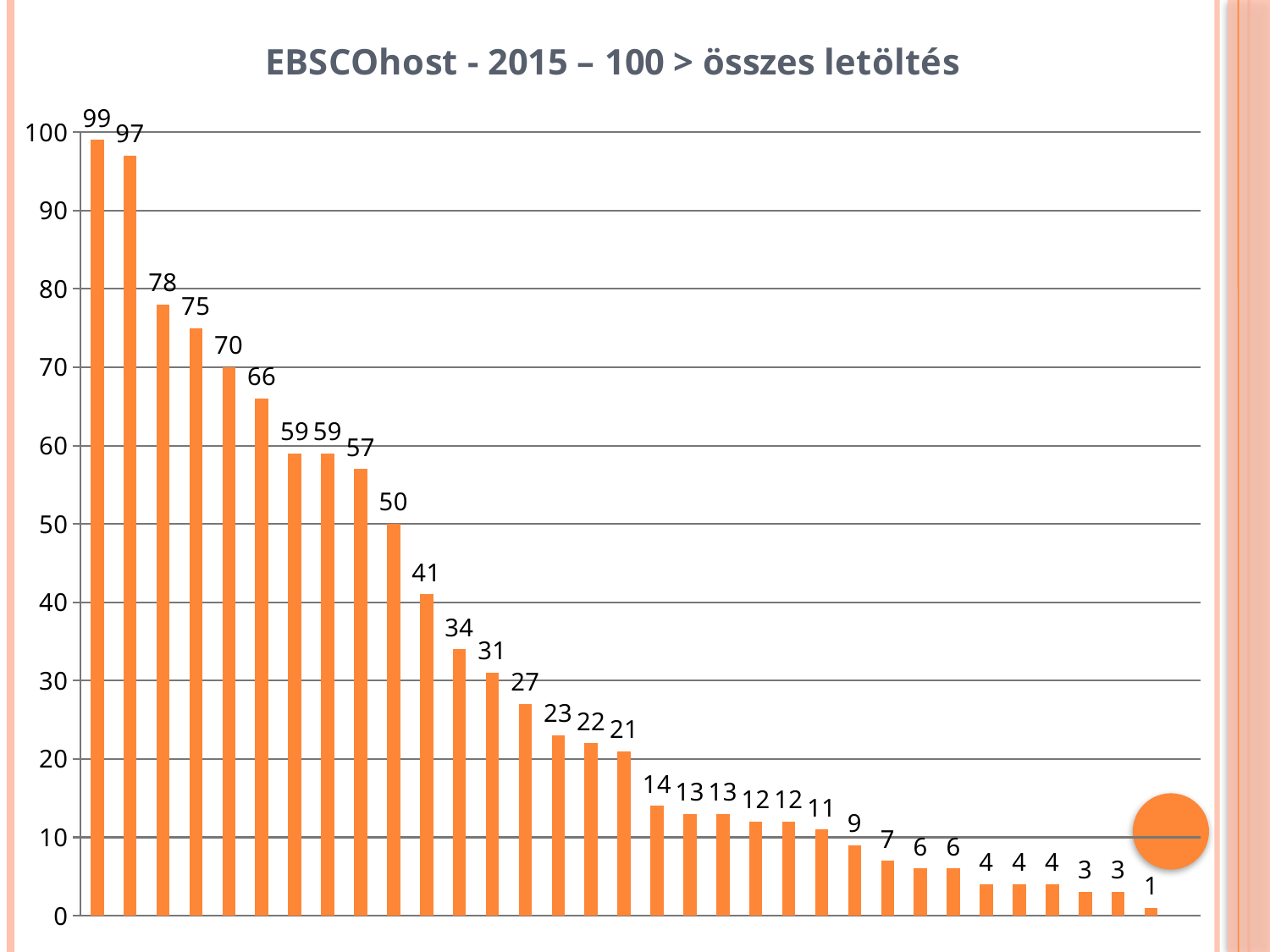
What colour are the bars in the chart? orange How many bars have a value of exactly 4? 3 Do the bar values rise or fall from left to right across the chart? fall How many bars are plotted in the chart? 33 What is the value of the leftmost bar? 99 What is the highest value shown in the chart? 99 What is the lowest value shown in the chart? 1 What is the value of the rightmost bar? 1 What kind of chart is shown on the slide? bar chart What is the difference between the first bar (99) and the second bar (97)? 2 Which is larger, the third bar from the left or the fourth bar from the left? the third bar (78) What is the title of the chart? EBSCOhost - 2015 – 100 > összes letöltés